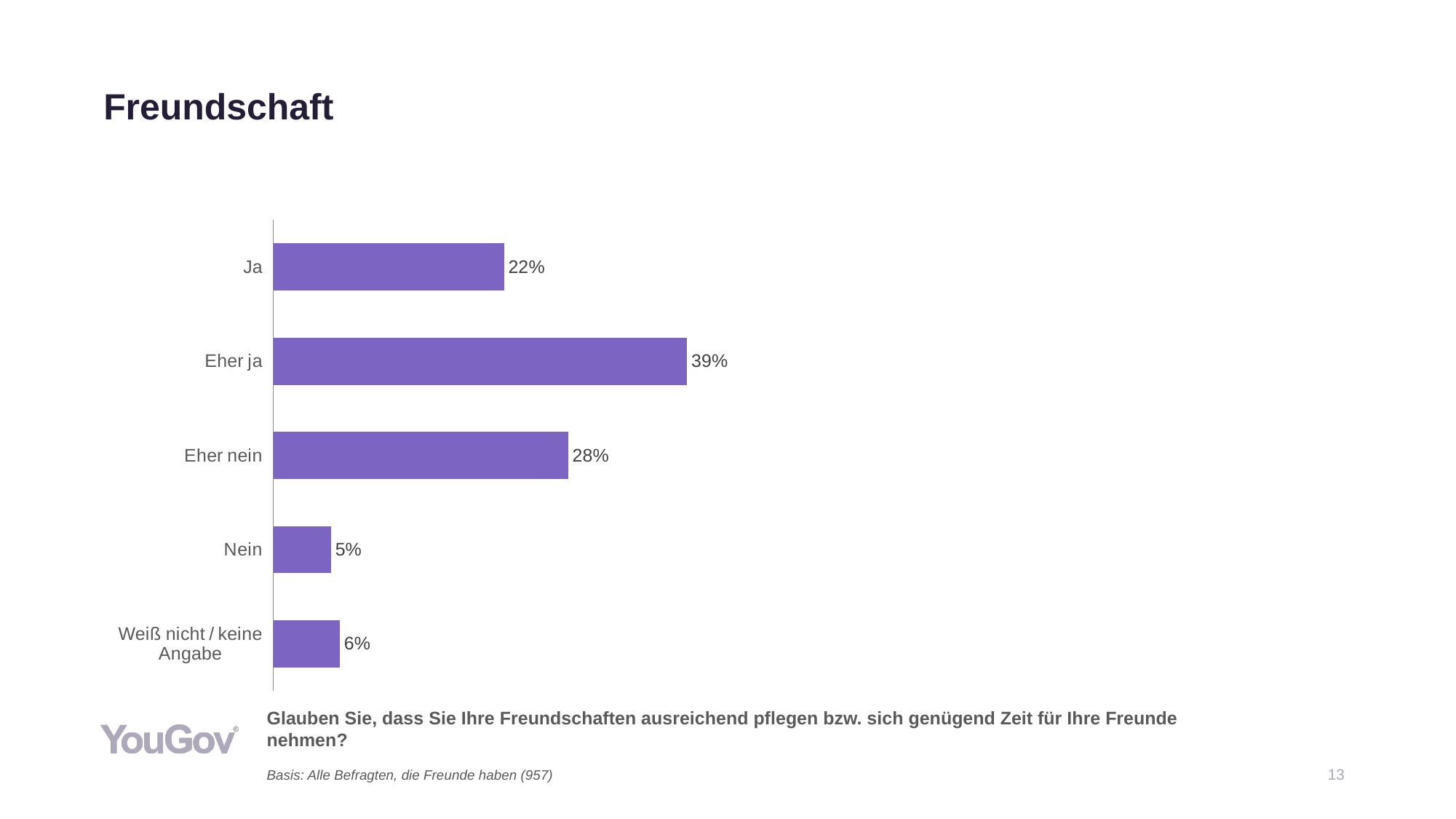
What is the value for "Eher ja"? 39% Which category has the lowest value? Nein Which is larger, the value for "Ja" or the value for "Eher nein"? Eher nein What is the value for "Ja"? 22% What is the difference between the values for "Eher ja" and "Eher nein"? 11% What is the combined value of "Ja" and "Eher ja"? 61% What is the difference between the values for "Ja" and "Nein"? 17% What kind of chart is shown on the slide? Bar chart What is the title of the slide? Freundschaft Which category has the highest value? Eher ja What is the value for "Weiß nicht / keine Angabe"? 6% How many categories are shown in the chart? 5